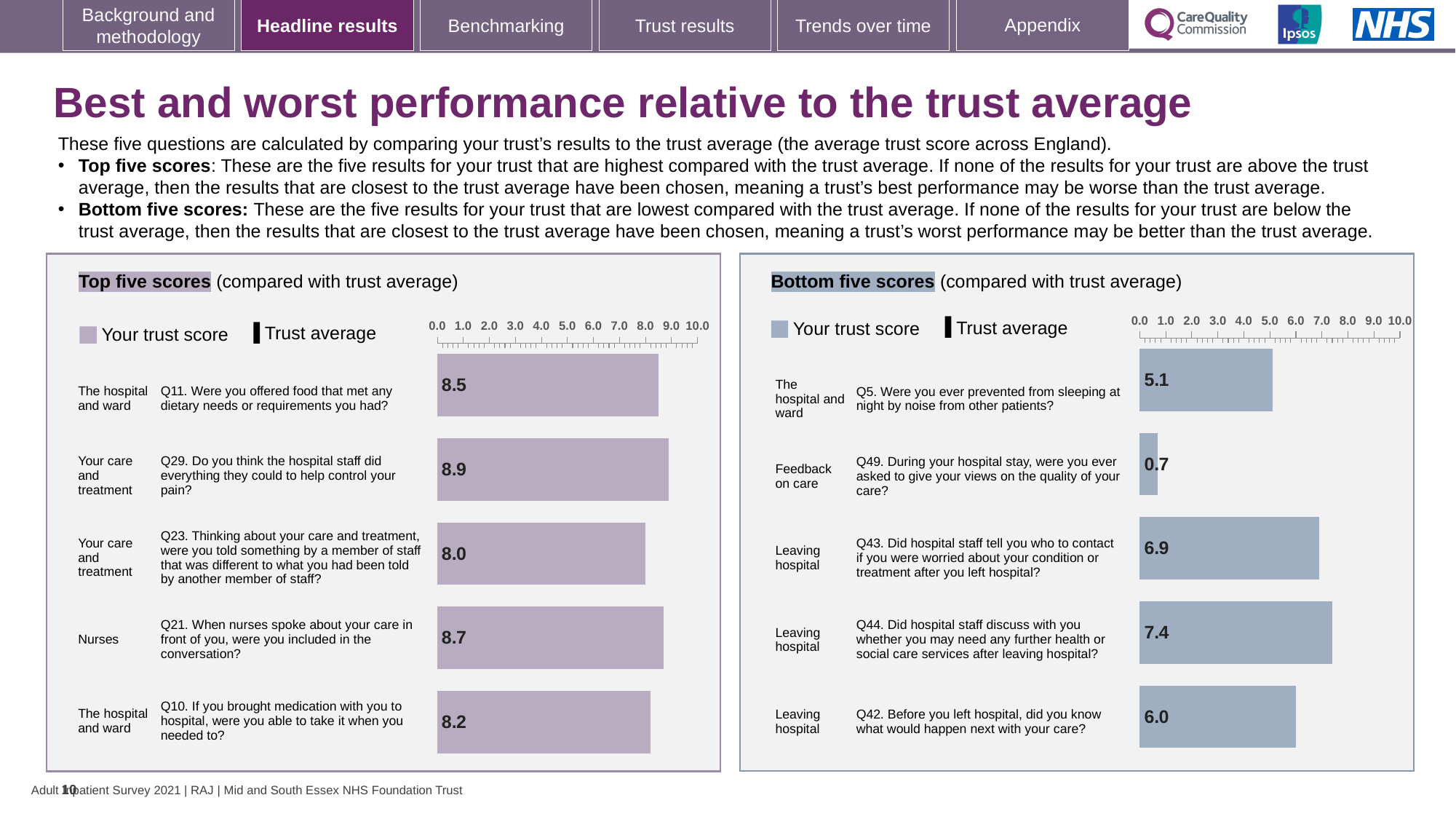
What kind of chart is used in the Top five scores panel? Bar chart In the Bottom five scores chart, which question has the highest trust score? Q44 In the Bottom five scores chart, what is the trust score for Q5 about being prevented from sleeping by noise from other patients? 5.1 In the Top five scores chart, which question has the lowest trust score? Q23 How many entries does the legend of the Bottom five scores chart list? 2 In the Bottom five scores chart, what is the trust score for Q49 about being asked to give your views on the quality of your care? 0.7 In the Top five scores chart, what is the trust score for Q29 about hospital staff helping to control pain? 8.9 In the Bottom five scores chart, what is the difference between the trust scores for Q44 and Q42? 1.4 In the Top five scores chart, what is the difference between the trust scores for Q29 and Q23? 0.9 In the Top five scores chart, what is the trust score for Q10 about taking medication you brought to hospital? 8.2 In the Bottom five scores chart, is the trust score for Q43 or Q42 larger? Q43 In the Top five scores chart, how many questions are plotted? 5